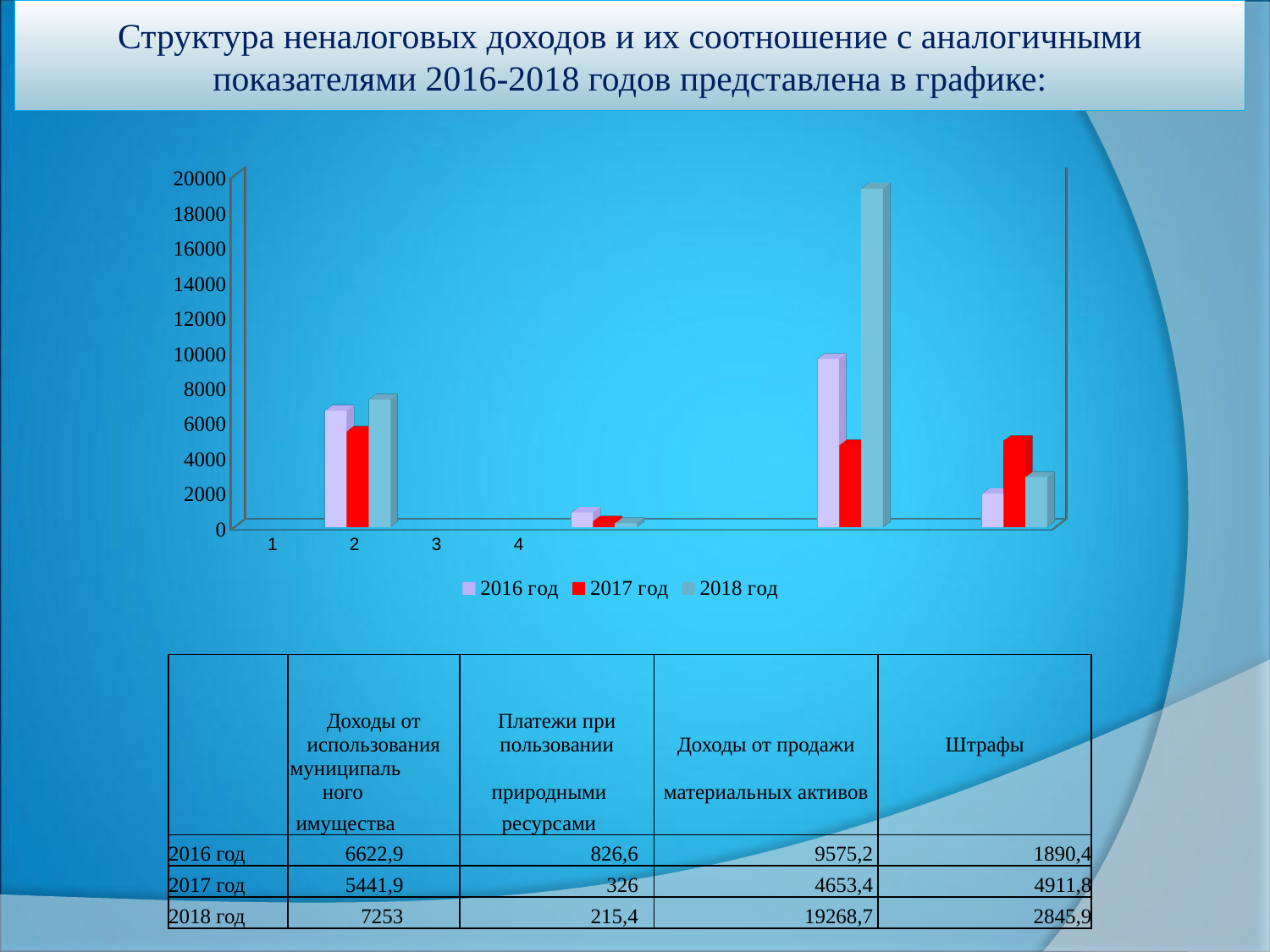
How many series does the chart legend list? 3 For Штрафы, which bar is taller: 2017 год or 2018 год? 2017 год According to the table on the slide, what is the 2016 год value for Штрафы? 1890,4 What are the three series named in the chart legend? 2016 год, 2017 год, 2018 год According to the table on the slide, what is the 2018 год value for Платежи при пользовании природными ресурсами? 215,4 What type of chart is shown on the slide? bar chart For Платежи при пользовании природными ресурсами, do the values rise or fall from 2016 год to 2018 год? fall Is the 2016 год bar for Доходы от использования муниципального имущества greater or less than 6000? greater Is the 2018 год bar for Доходы от продажи материальных активов greater or less than 18000? greater Using the table values, what is the difference between the 2018 год and 2016 год values for Доходы от использования муниципального имущества? 630,1 Which category has the tallest bar in the chart? Доходы от продажи материальных активов How many groups of bars (categories) are plotted in the chart? 4